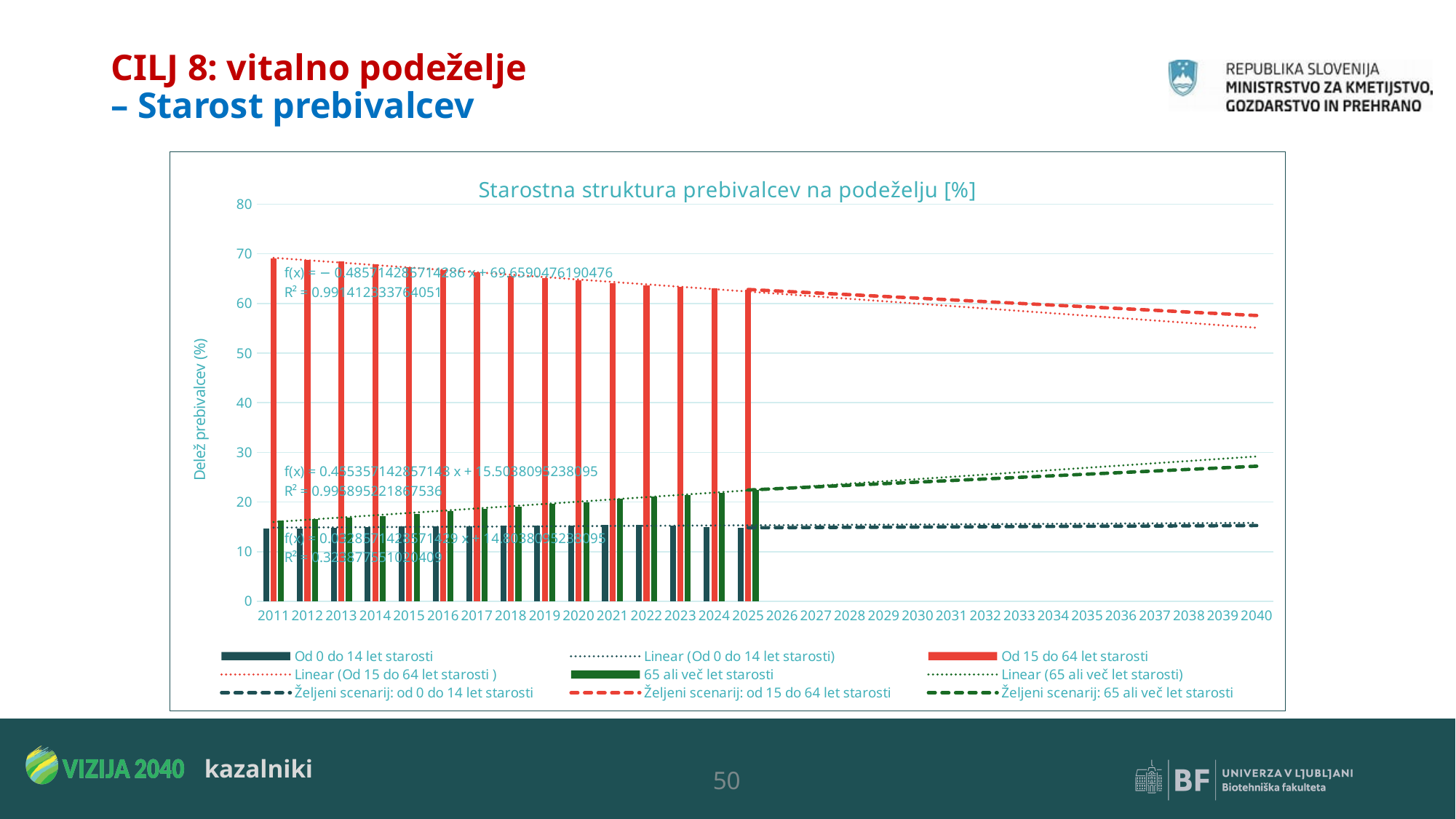
Is the value for 'Od 15 do 64 let starosti' in 2011 greater or less than 60? greater Which series has the lowest bar in 2025? Od 0 do 14 let starosti Is the value for 'Od 0 do 14 let starosti' in 2011 greater or less than 20? less How many entries does the chart legend list? 9 For how many years are bars plotted in the chart? 15 Do the bars for '65 ali več let starosti' rise or fall from 2011 to 2025? rise Is the value for '65 ali več let starosti' in 2025 greater or less than 20? greater What kind of chart is shown on the slide? combination bar and line chart What is the title of the chart? Starostna struktura prebivalcev na podeželju [%] How many year labels are shown on the x axis? 30 Do the bars for 'Od 15 do 64 let starosti' rise or fall from 2011 to 2025? fall